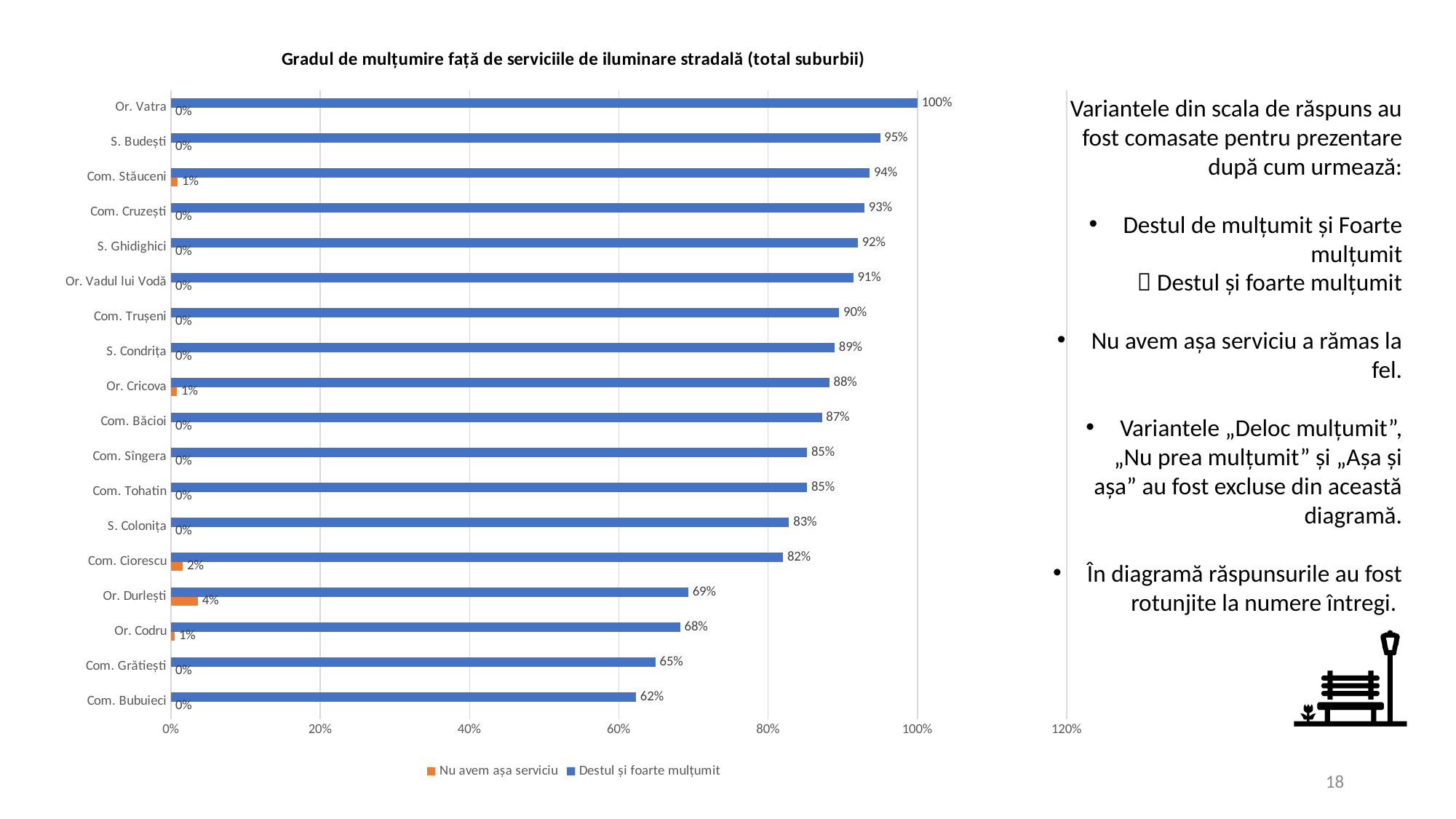
What is the 'Nu avem așa serviciu' value for Or. Durlești? 4% What is the title of the chart? Gradul de mulțumire față de serviciile de iluminare stradală (total suburbii) How many series does the legend list? 2 Which locality has the highest 'Destul și foarte mulțumit' value? Or. Vatra What type of chart is shown on the slide? Bar chart What is the 'Destul și foarte mulțumit' value for Or. Vatra? 100% What is the 'Nu avem așa serviciu' value for Com. Ciorescu? 2% Which locality has the lowest 'Destul și foarte mulțumit' value? Com. Bubuieci What is the difference between the 'Destul și foarte mulțumit' values for S. Budești and Or. Codru? 27% Which has a larger 'Destul și foarte mulțumit' value, Com. Ciorescu or Or. Durlești? Com. Ciorescu What is the 'Destul și foarte mulțumit' value for Com. Bubuieci? 62% How many localities are listed on the chart? 18